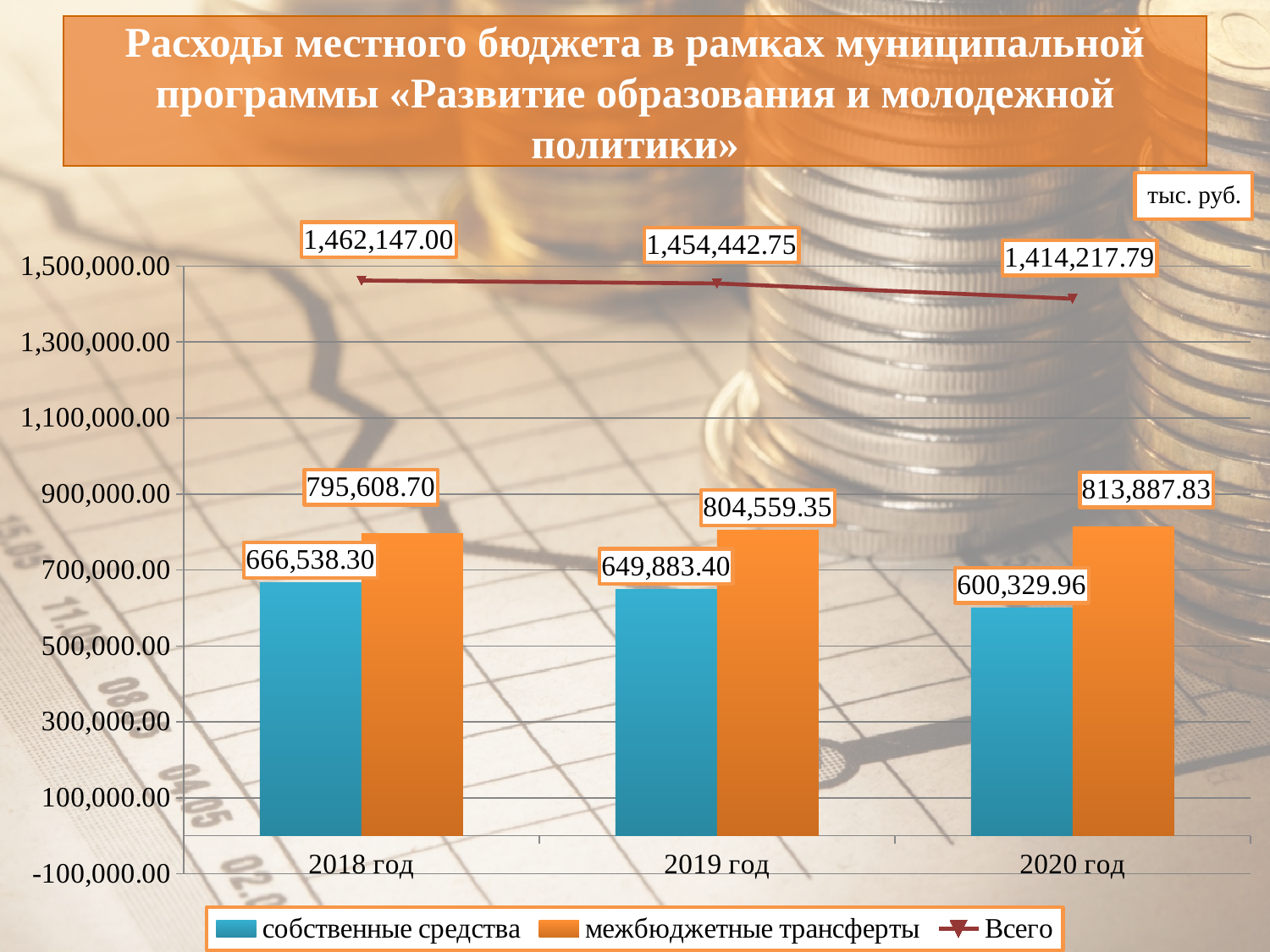
In which year is «межбюджетные трансферты» the highest? 2020 год What is the value of «собственные средства» for 2018 год? 666,538.30 What is the value of «Всего» for 2020 год? 1,414,217.79 What unit is indicated in the top right corner of the chart? тыс. руб. In which year is «собственные средства» the lowest? 2020 год What is the difference between «межбюджетные трансферты» and «собственные средства» in 2018 год? 129,070.40 What is the value of «межбюджетные трансферты» for 2019 год? 804,559.35 Does the «Всего» line rise or fall from 2018 год to 2020 год? fall How many series does the legend list? 3 What is the difference between the «Всего» values for 2018 год and 2020 год? 47,929.21 How many years are shown on the x axis? 3 Which is larger in 2020 год: «собственные средства» or «межбюджетные трансферты»? межбюджетные трансферты